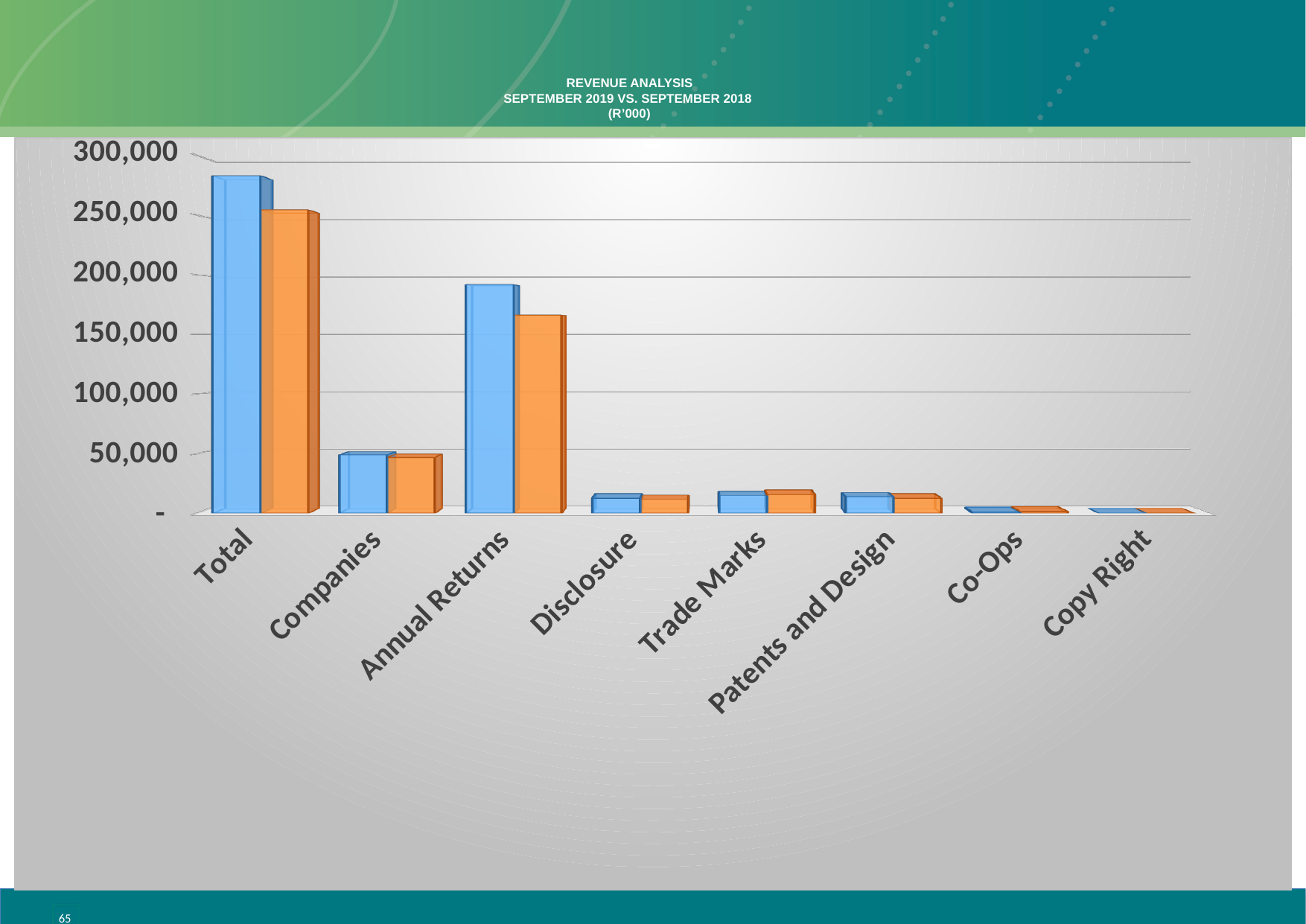
What unit is stated in the chart title? R'000 Which category has the tallest bar in the chart? Total Which category has the lowest bars in the chart? Copy Right For the Annual Returns category, is the blue bar or the orange bar taller? Blue Is the value of the blue bar for Companies greater or less than 100,000? less Excluding Total, which category has the tallest bar? Annual Returns For the Total category, is the blue bar or the orange bar taller? Blue Is the value of the blue bar for Total greater or less than 250,000? greater Is the value of the orange bar for Disclosure greater or less than 50,000? less How many categories are shown on the x axis of the chart? 8 What kind of chart is shown on the slide? Bar chart